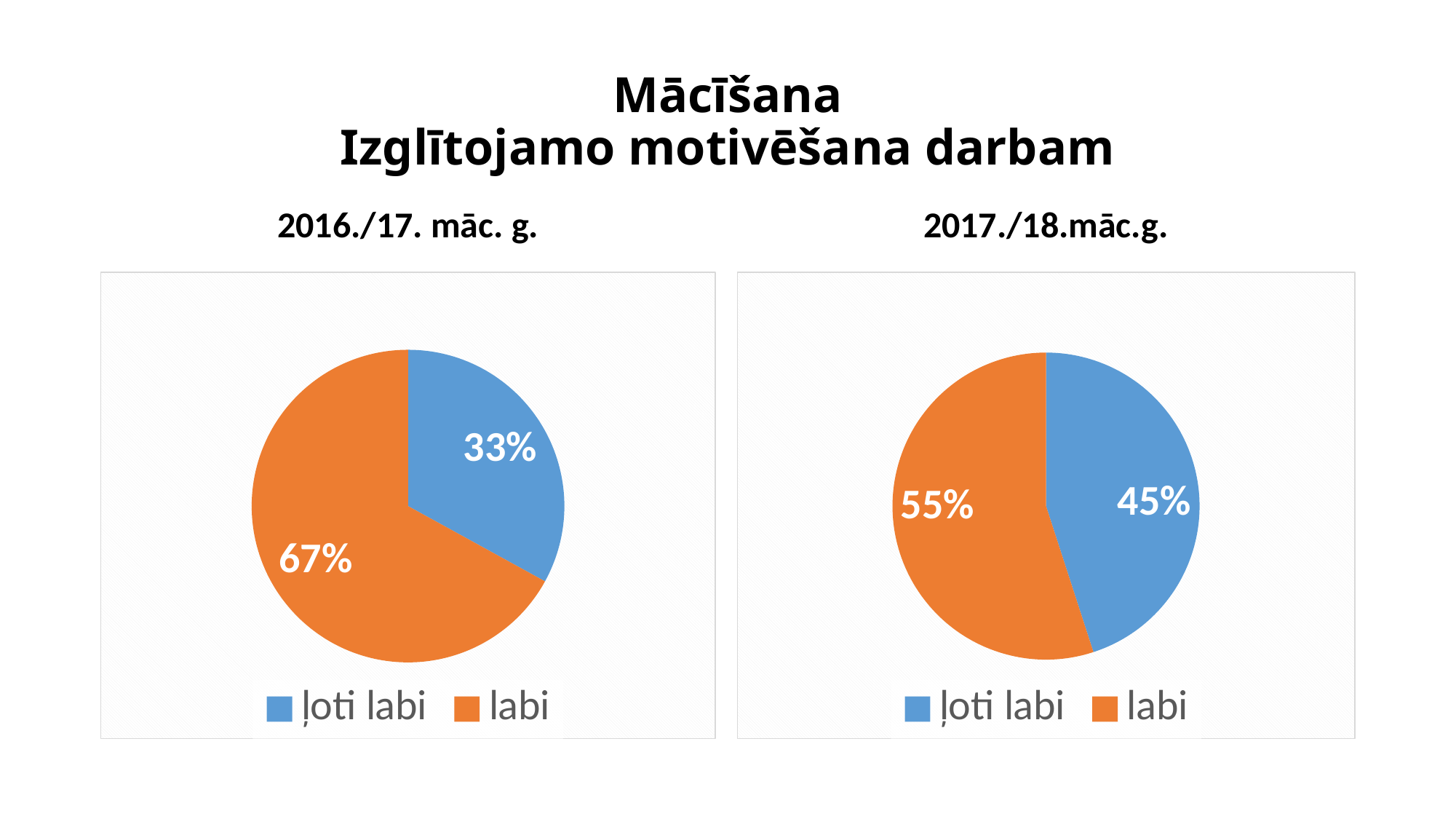
In the 2017./18.māc.g. chart, what share of the pie is 'labi'? 55% In the 2016./17. māc. g. chart, what share of the pie is 'ļoti labi'? 33% What kind of chart is the 2016./17. māc. g. chart? Pie chart In the 2016./17. māc. g. chart, what share of the pie is 'labi'? 67% In the 2017./18.māc.g. chart, what is the difference between the 'labi' and 'ļoti labi' shares? 10% In the 2017./18.māc.g. chart, which category has the smallest slice? ļoti labi In the 2016./17. māc. g. chart, which category has the largest slice? labi In the 2016./17. māc. g. chart, which colour represents 'labi'? Orange Which chart has the larger 'ļoti labi' share, 2016./17. māc. g. or 2017./18.māc.g.? 2017./18.māc.g. In the 2016./17. māc. g. chart, what is the difference between the 'labi' and 'ļoti labi' shares? 34% How many categories does the 2017./18.māc.g. chart show? 2